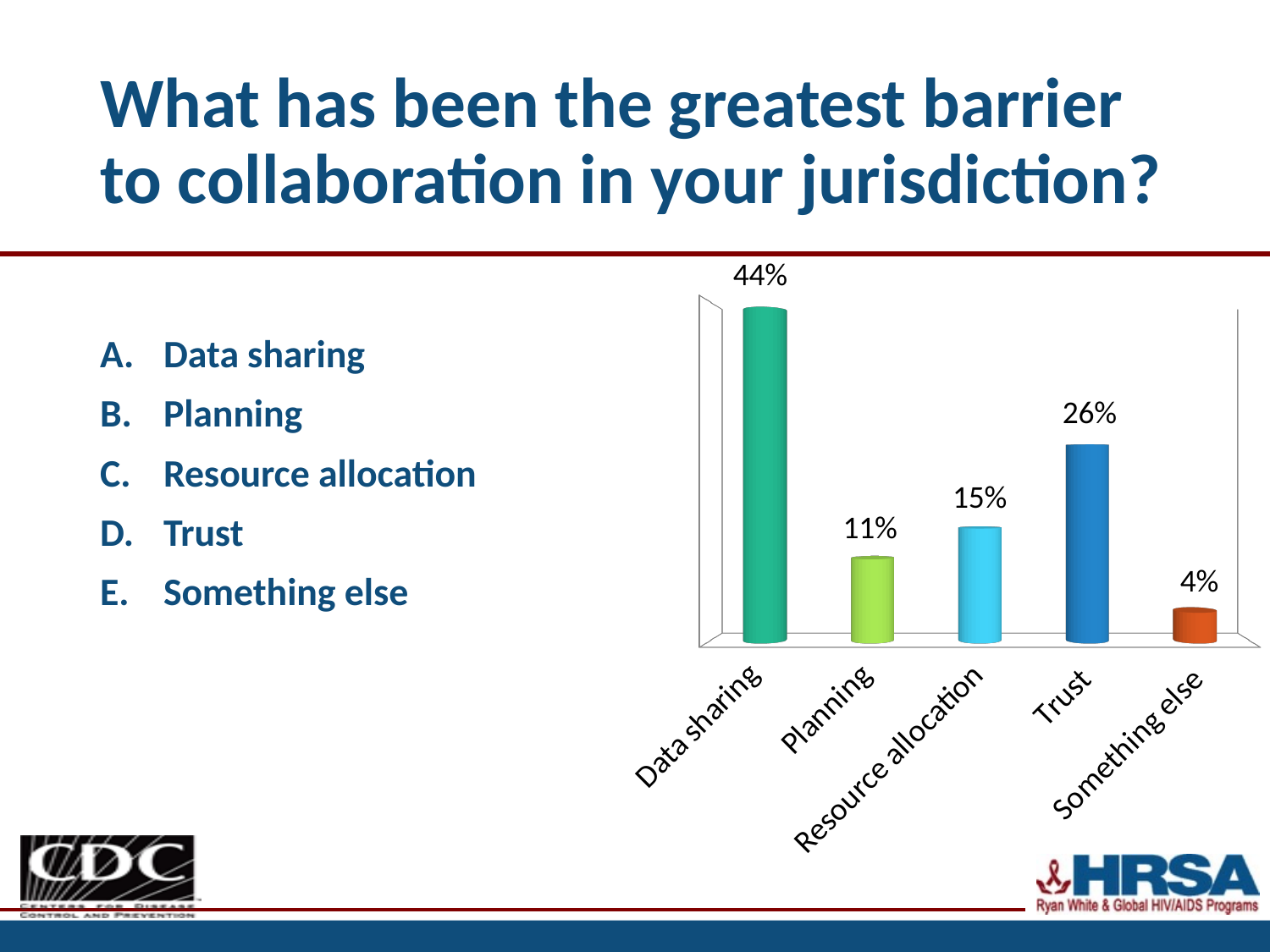
What is the value shown for Resource allocation? 15% Which category has the lowest value? Something else What kind of chart is shown on the slide? Bar chart Which category has the highest value? Data sharing How many categories are shown in the chart? 5 What colour is the bar for Something else? Orange What is the value shown for Planning? 11% What is the difference between the values for Resource allocation and Planning? 4% What is the value shown for Trust? 26% What percentage of respondents chose Data sharing as the greatest barrier? 44% Which is larger, the value for Trust or the value for Resource allocation? Trust What is the difference between the values for Data sharing and Trust? 18%